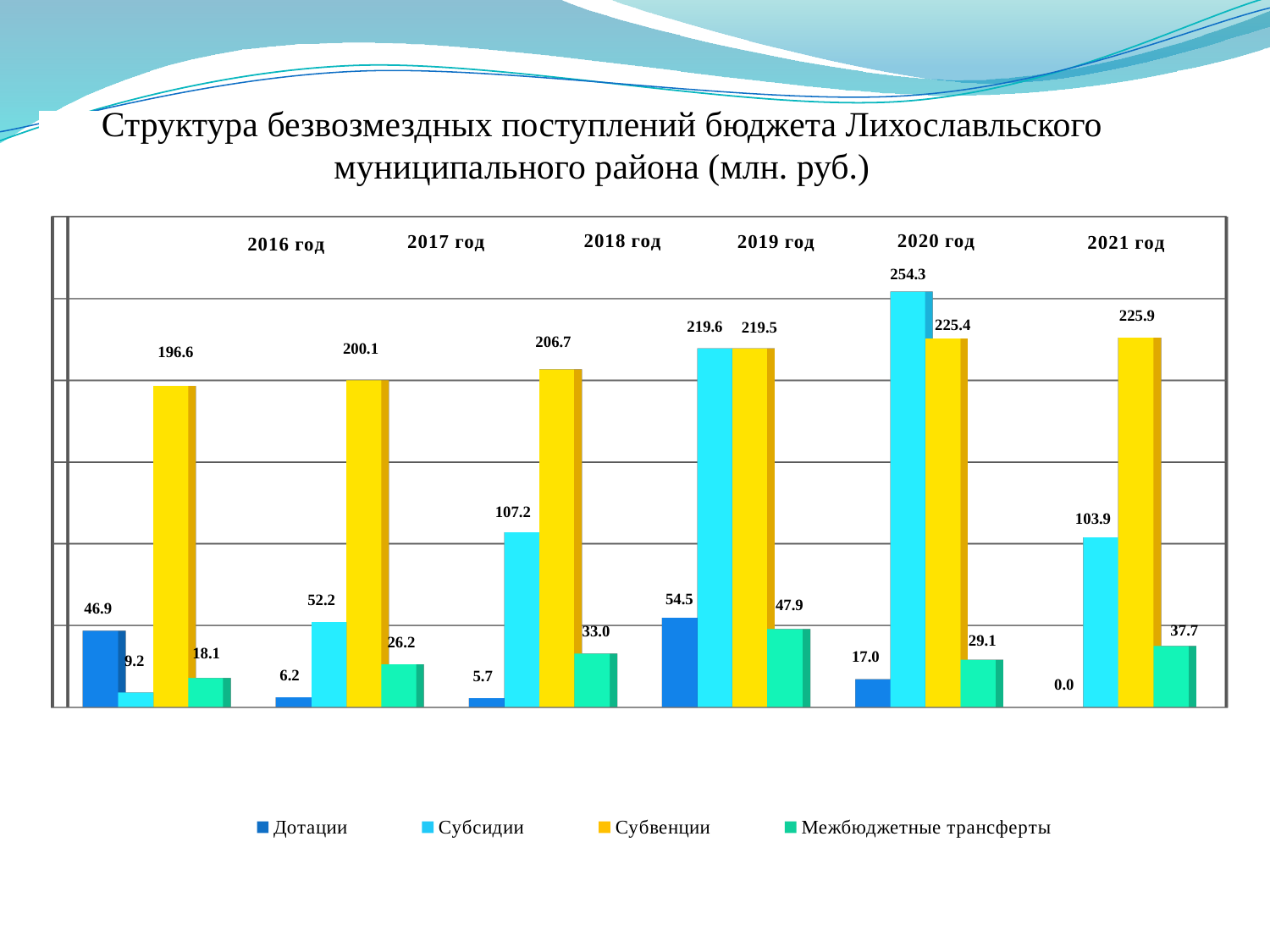
What is the value of Субсидии for 2020 год? 254.3 What is the value of Субвенции for 2016 год? 196.6 How many years are shown on the x axis? 6 In which year is the Субсидии value the highest? 2020 год What is the value of Межбюджетные трансферты for 2018 год? 33.0 In which year is the Дотации value the lowest? 2021 год How many series does the legend list? 4 What is the difference between Субвенции in 2021 год and Субвенции in 2016 год? 29.3 What is the value of Дотации for 2021 год? 0.0 What type of chart is shown on the slide? Bar chart Does the Субвенции value rise or fall from 2016 год to 2021 год? Rise Which is larger in 2017 год: Субсидии or Межбюджетные трансферты? Субсидии